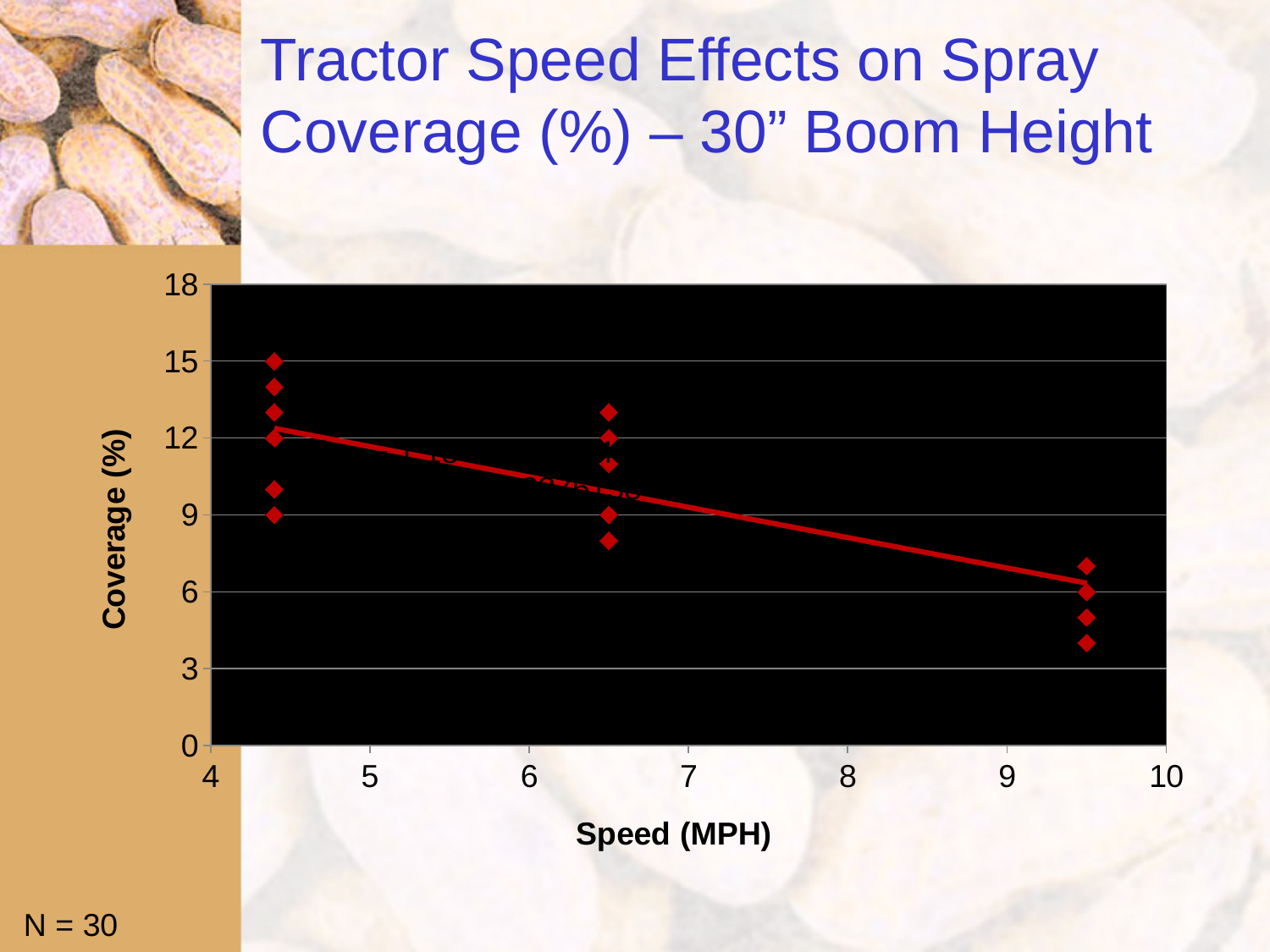
What kind of chart is shown on the slide? scatter chart Which speed group has higher coverage values: the slowest (about 4.4 MPH) or the fastest (about 9.5 MPH)? the slowest (about 4.4 MPH) What is the label of the x axis? Speed (MPH) At how many distinct speeds are data points plotted? 3 What is the highest coverage value plotted on the chart? 15 What is the label of the y axis? Coverage (%) Is the lowest coverage value at the fastest speed (about 9.5 MPH) greater or less than 6? less As speed increases along the x axis, does spray coverage rise or fall? fall What is the maximum value shown on the y axis? 18 Is the highest coverage value at the fastest speed (about 9.5 MPH) greater or less than 9? less Is the lowest coverage value at the slowest speed (about 4.4 MPH) greater or less than 6? greater